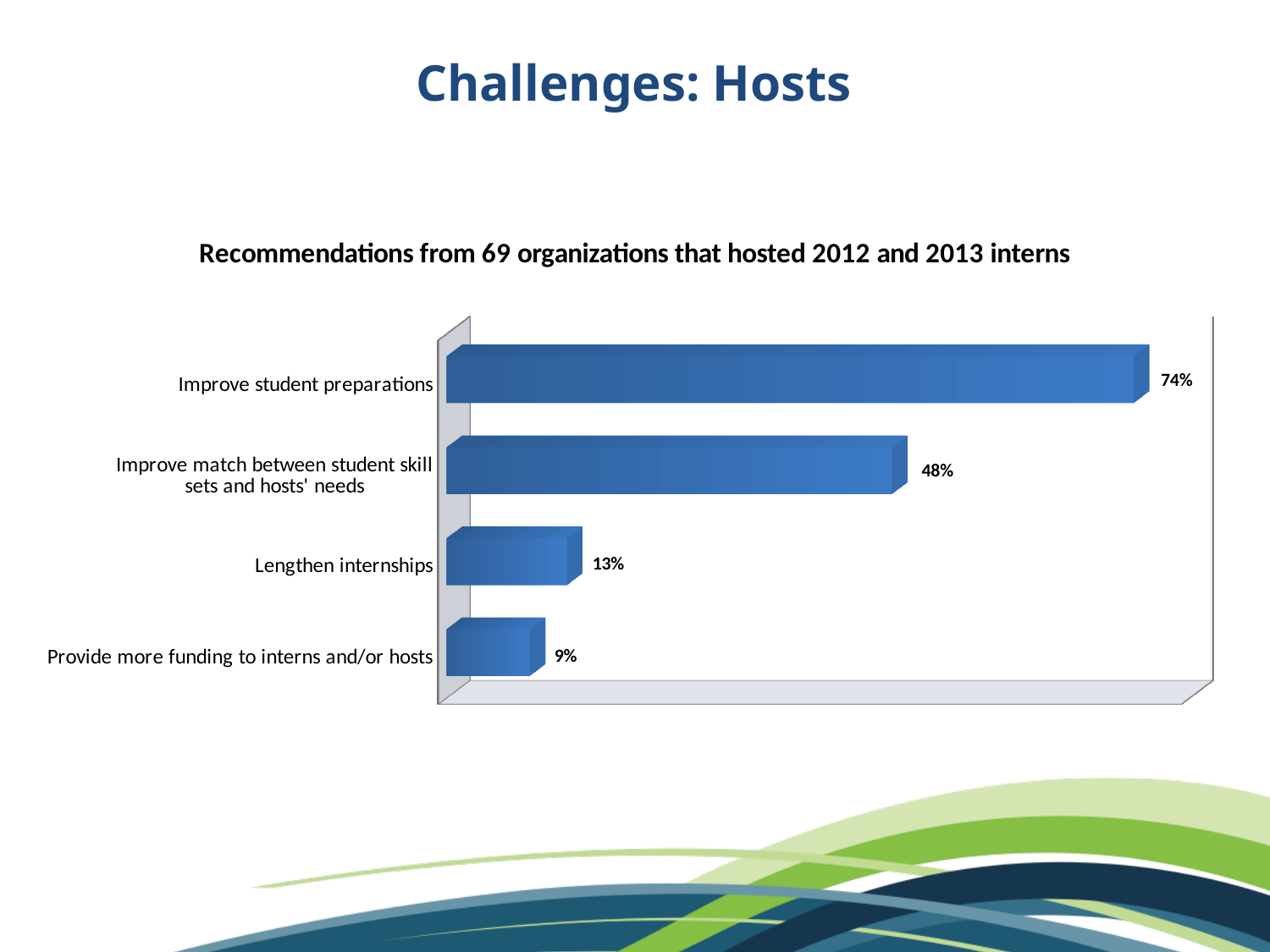
What is the value for 'Provide more funding to interns and/or hosts'? 9% What is the value for 'Improve match between student skill sets and hosts' needs'? 48% Which recommendation has the highest percentage? Improve student preparations How many recommendation categories are shown in the chart? 4 What percentage of hosts recommended lengthening internships? 13% What is the difference between the percentages for 'Lengthen internships' and 'Provide more funding to interns and/or hosts'? 4% Which has a larger value: 'Lengthen internships' or 'Provide more funding to interns and/or hosts'? Lengthen internships What is the title of the chart? Recommendations from 69 organizations that hosted 2012 and 2013 interns What percentage of hosts recommended improving student preparations? 74% Which recommendation has the lowest percentage? Provide more funding to interns and/or hosts What is the difference between the percentages for 'Improve student preparations' and 'Improve match between student skill sets and hosts' needs'? 26% What type of chart is shown on the slide? Bar chart